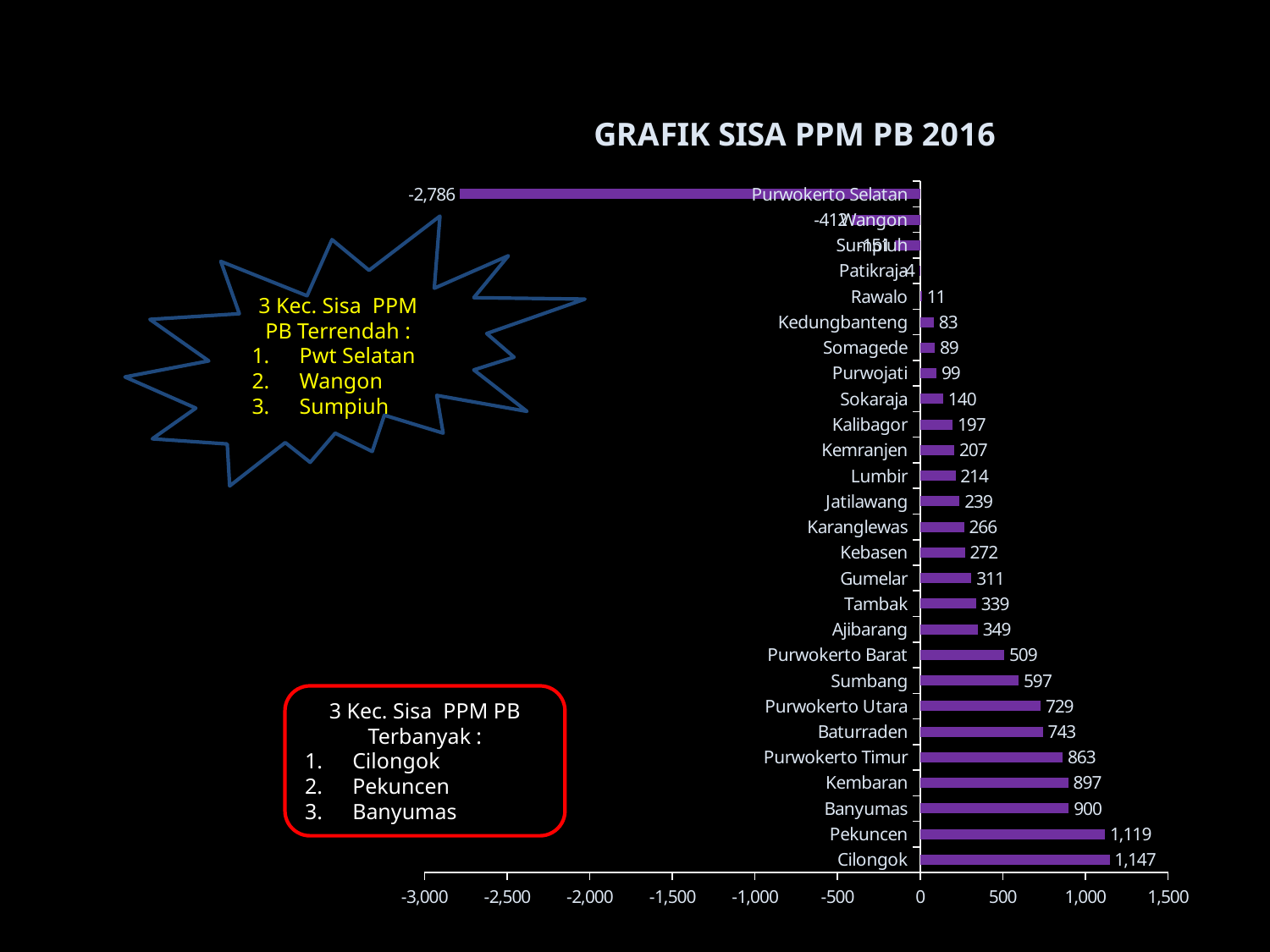
What is the value for Sokaraja? 140 What is the value for Banyumas? 900 Which category has the lowest value? Purwokerto Selatan What is the value for Purwokerto Selatan? -2,786 What kind of chart is shown on the slide? Bar chart How many categories are shown in the chart? 27 Which has a larger value, Kembaran or Banyumas? Banyumas What is the difference between the values for Cilongok and Pekuncen? 28 What is the difference between the values for Purwokerto Timur and Sumbang? 266 Which category has the highest value? Cilongok What is the value for Cilongok? 1,147 What is the title of the chart? GRAFIK SISA PPM PB 2016